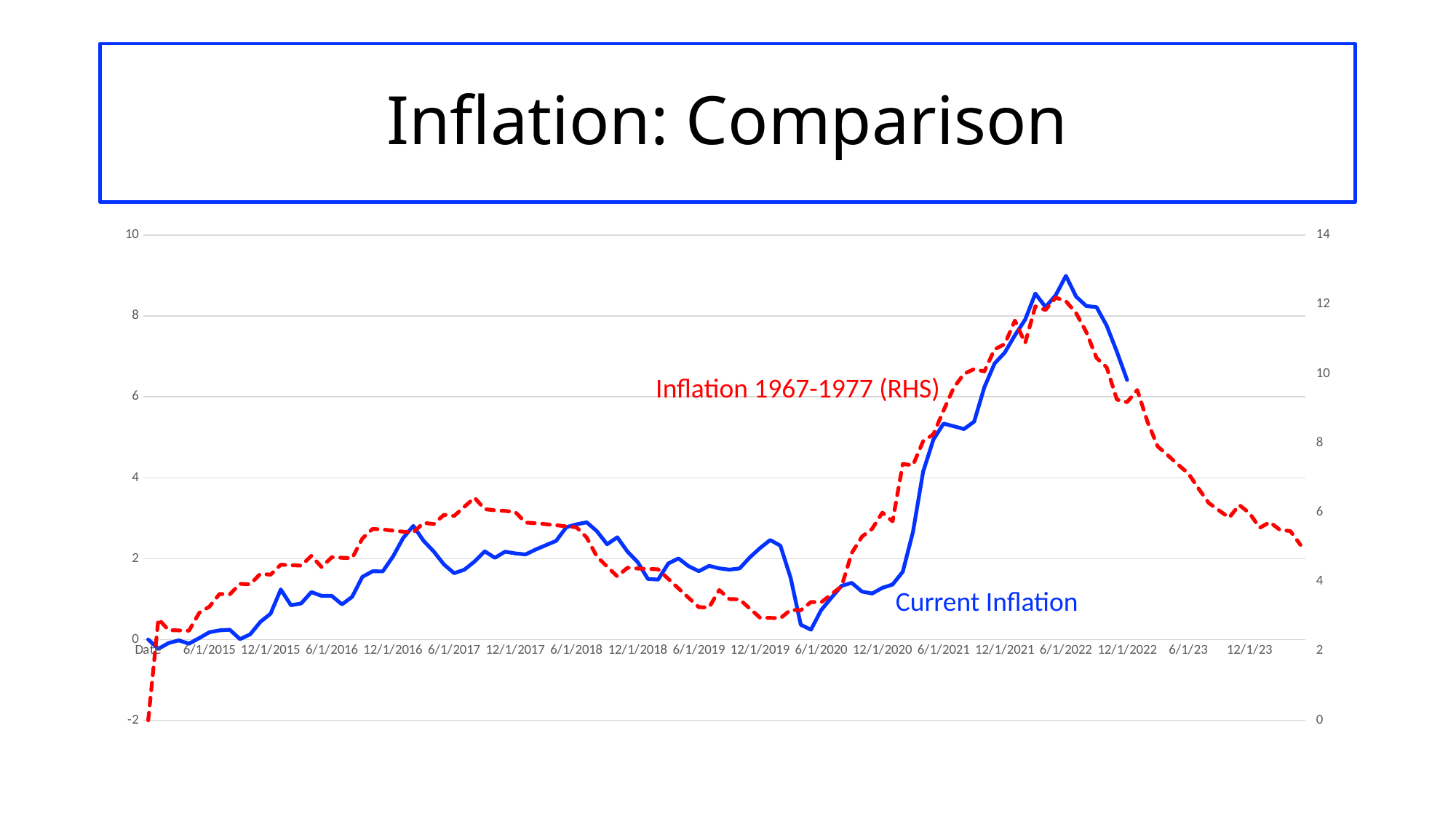
Does Current Inflation rise or fall between 6/1/2020 and 6/1/2022? rise What kind of chart is shown on the slide? line chart Is the peak value of Current Inflation around 6/1/2022 greater or less than 8? greater Is the value for Inflation 1967-1977 (RHS) at 12/1/23 greater or less than 8 on the right axis? less Does Inflation 1967-1977 (RHS) rise or fall between 6/1/2022 and 12/1/23? fall Is the value for Current Inflation at 6/1/2020 greater or less than 2? less Which axis is the Inflation 1967-1977 series plotted against? right-hand side (RHS) What is the title of the slide? Inflation: Comparison Around which date does Current Inflation reach its highest value? 6/1/2022 How many series are plotted on the chart? 2